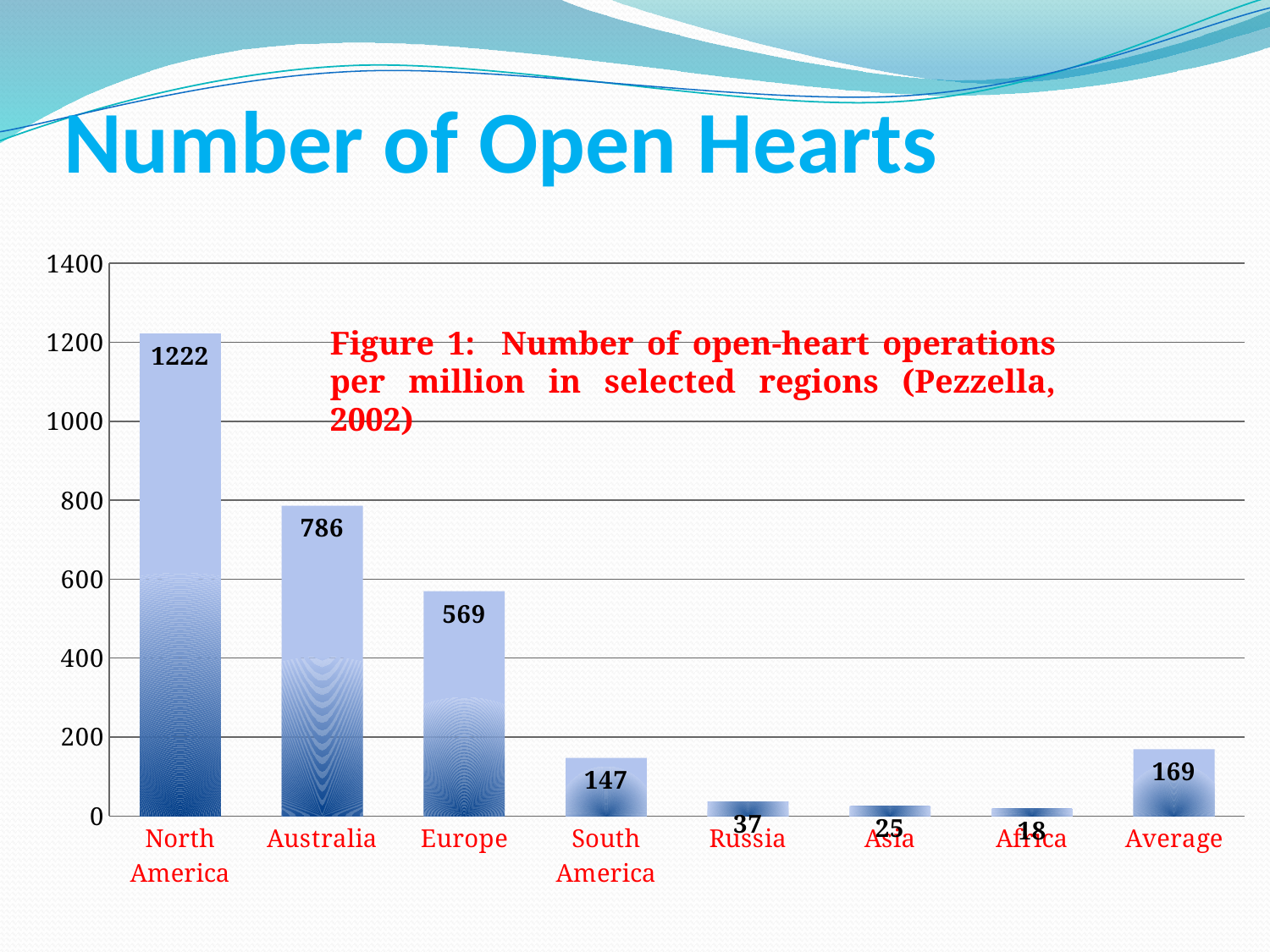
Which category has the highest value? North America What is the value for North America? 1222 Which category has the lowest value? Africa How many categories are shown on the x axis? 8 What is the title of the slide? Number of Open Hearts What is the difference between the values for Australia and Europe? 217 What is the value for Europe? 569 Is the value for Australia greater or less than 600? greater What is the value for Average? 169 What is the value for Russia? 37 Which is larger, the value for South America or the value for Average? Average What kind of chart is this? bar chart